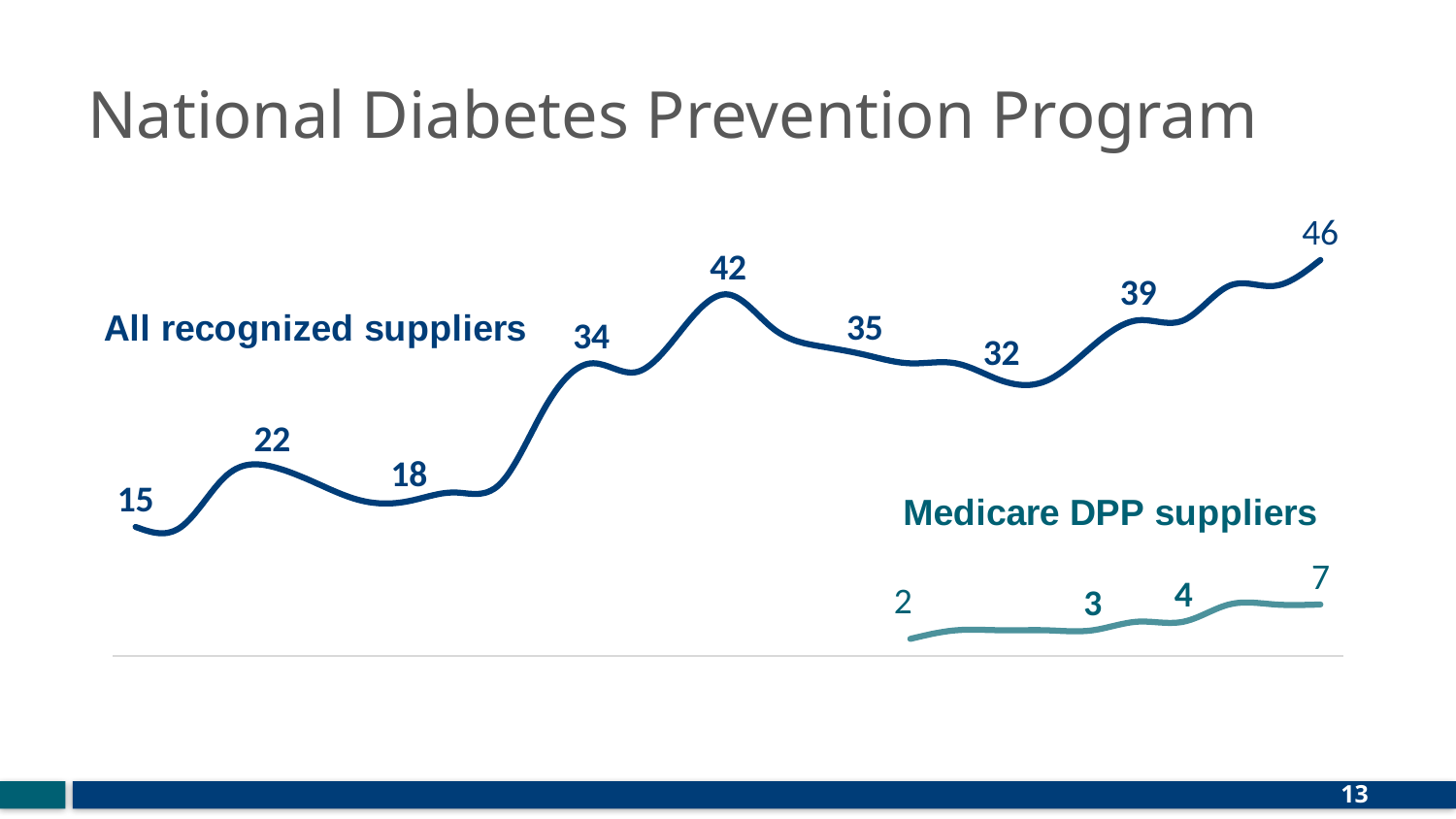
What kind of chart is shown on the slide? line chart How many data points are labelled on the All recognized suppliers line? 9 Which is larger, the final value of All recognized suppliers or the final value of Medicare DPP suppliers? All recognized suppliers What is the difference between the last and first values of the All recognized suppliers line? 31 How many series are plotted on the chart? 2 What is the lowest value on the All recognized suppliers line? 15 What is the last value of the Medicare DPP suppliers line? 7 What is the first value of the All recognized suppliers line? 15 What is the lowest value on the Medicare DPP suppliers line? 2 How many data points are labelled on the Medicare DPP suppliers line? 4 What is the highest value on the All recognized suppliers line? 46 What is the last value of the All recognized suppliers line? 46